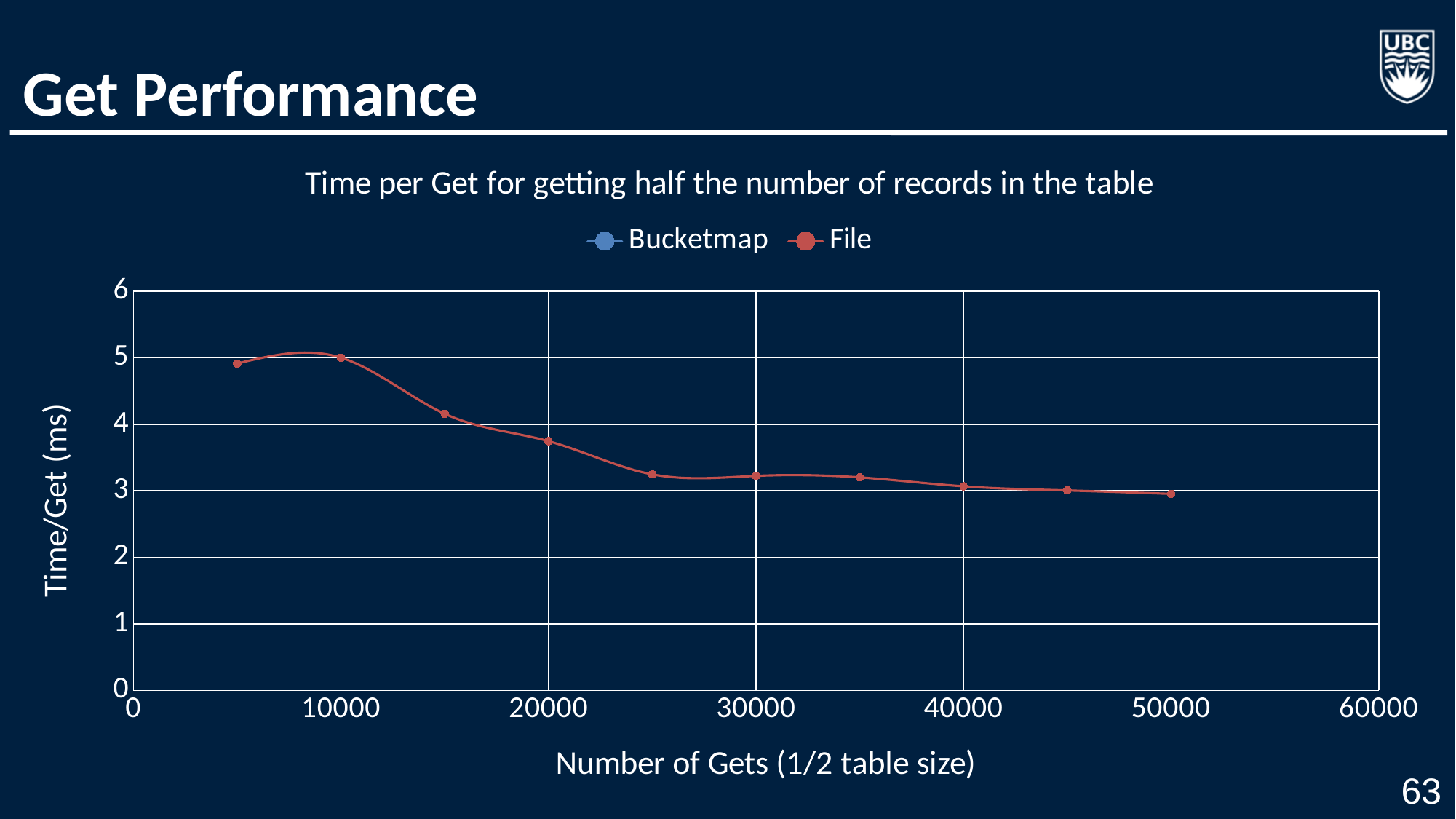
Which has a larger Time/Get for the File series: 10000 gets or 25000 gets? 10000 gets Is the File series value at 5000 gets greater or less than 4 ms? greater Is the File series value at 30000 gets greater or less than 3 ms? greater How many series does the legend list? 2 What is the label of the y axis? Time/Get (ms) Is the File series value at 20000 gets greater or less than 4 ms? less Which has a larger Time/Get for the File series: 5000 gets or 50000 gets? 5000 gets Does the Time/Get for the File series rise or fall as the Number of Gets increases? fall How many data points are plotted for the File series? 10 What kind of chart is shown on the slide? line chart What is the title of the chart? Time per Get for getting half the number of records in the table